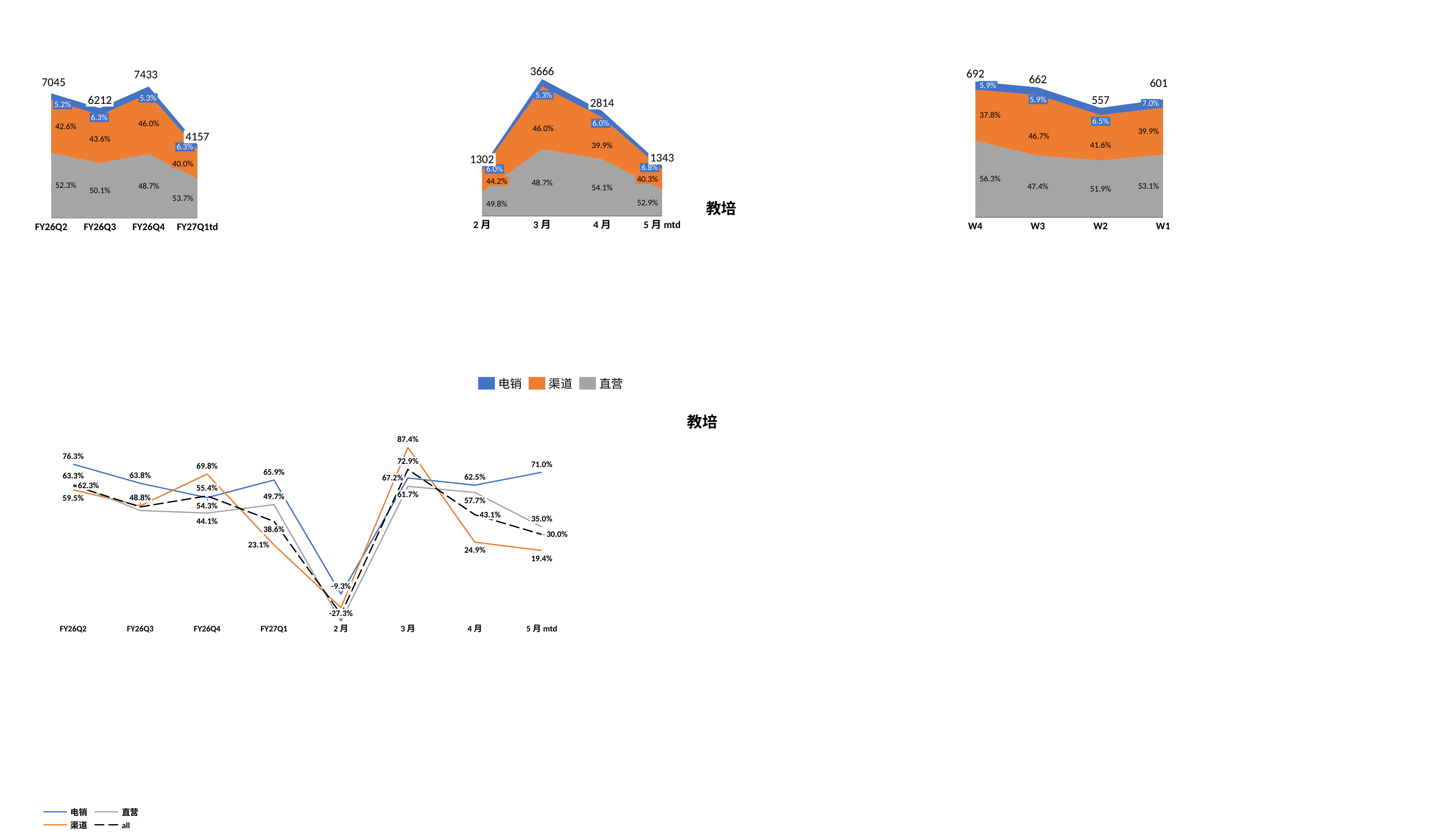
In the top-left stacked area chart, what is the total value labeled for FY26Q4? 7433 In the top-middle stacked area chart, what is the total value labeled for 3月? 3666 In the top-left stacked area chart, which period has the lowest total value? FY27Q1td In the top-right stacked area chart, which week has the highest total value? W4 In the top-middle stacked area chart, what is the difference between the totals for 3月 and 4月? 852 In the bottom line chart, what is the value of 渠道 at 3月? 87.4% In the top-right stacked area chart, is the 直营 share larger in W4 or W3? W4 In the top-middle stacked area chart, what share does 渠道 have in 4月? 39.9% In the top-left stacked area chart, what share does 直营 have in FY27Q1td? 53.7% In the bottom line chart, what is the value of 电销 at 5月 mtd? 71.0% How many series does the legend of the bottom line chart list? 4 In the top-right stacked area chart, what share does 电销 have in W1? 7.0%